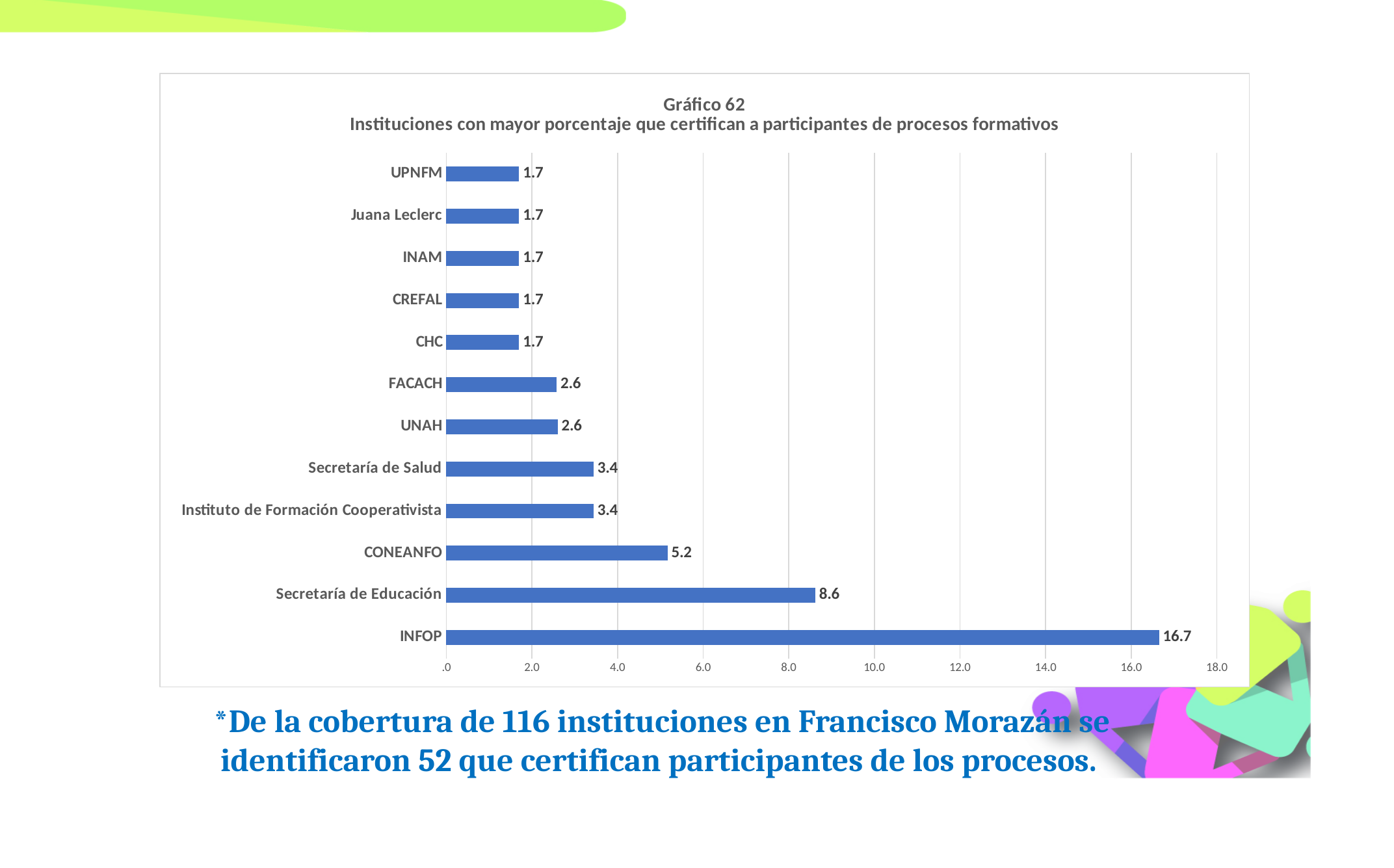
Is the value for Secretaría de Educación greater or less than 10.0? less What is the value for INFOP? 16.7 Which institution has the highest value? INFOP What is the difference between the values for CONEANFO and UNAH? 2.6 How many institutions are shown in the chart? 12 What kind of chart is shown on the slide? Bar chart What is the number of the chart given in its title? Gráfico 62 What is the difference between the values for INFOP and Secretaría de Educación? 8.1 What is the value for Secretaría de Salud? 3.4 What is the value for CONEANFO? 5.2 What is the value for Secretaría de Educación? 8.6 Which is larger, the value for CONEANFO or the value for FACACH? CONEANFO